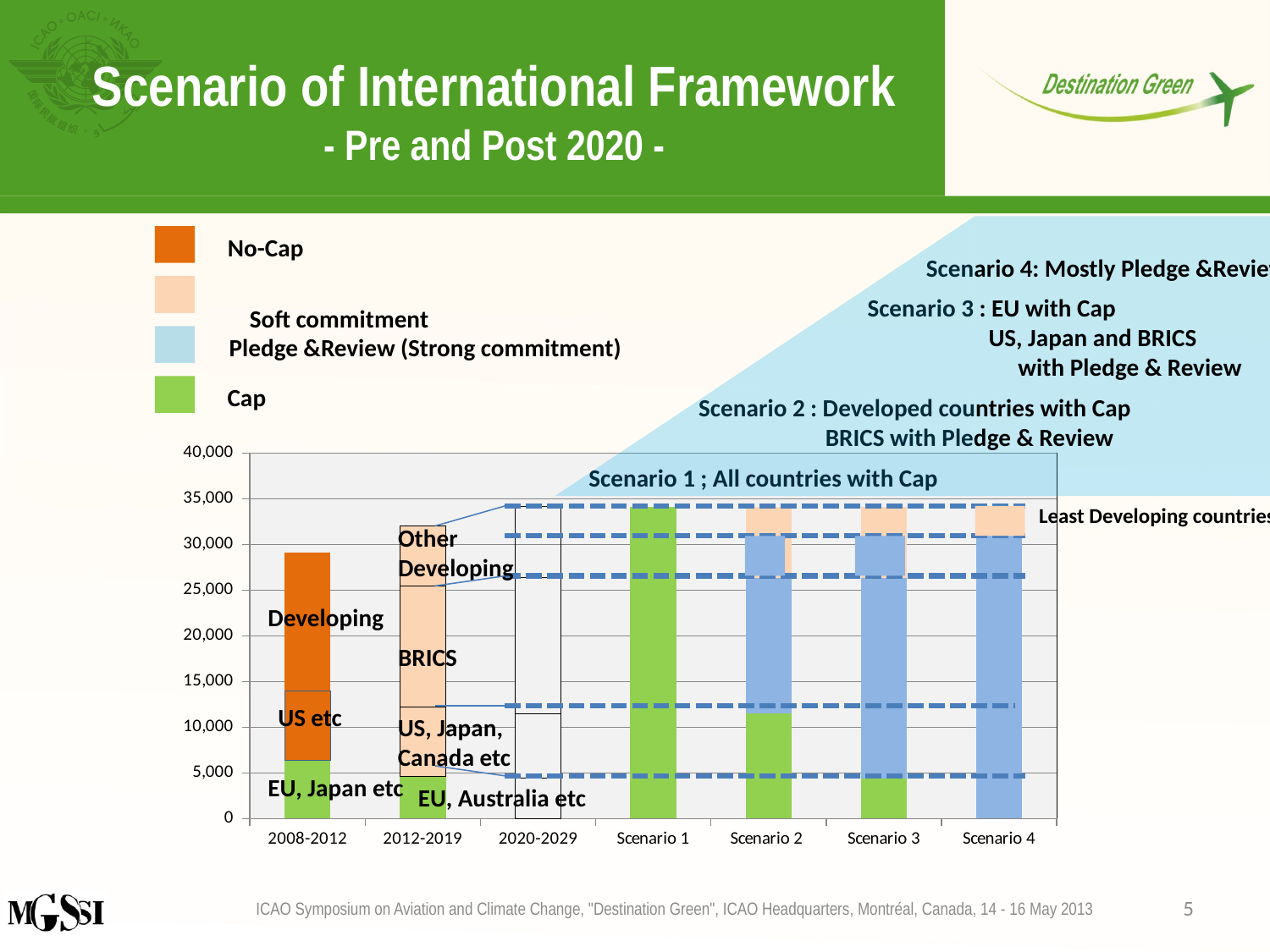
What kind of chart is shown on the slide? Stacked bar chart Which scenario has a larger green (Cap) segment, Scenario 2 or Scenario 3? Scenario 2 Which colour represents 'Cap' in the legend? Green What is the highest value shown on the y axis? 40,000 Is the green (Cap) segment of the Scenario 3 bar greater or less than 10,000? less How many entries does the legend list? 4 How many categories are shown along the x axis of the chart? 7 Is the total height of the 2012-2019 bar greater or less than 30,000? greater Is the green (Cap) segment of the Scenario 2 bar greater or less than 10,000? greater Which bar is taller in total, 2008-2012 or 2012-2019? 2012-2019